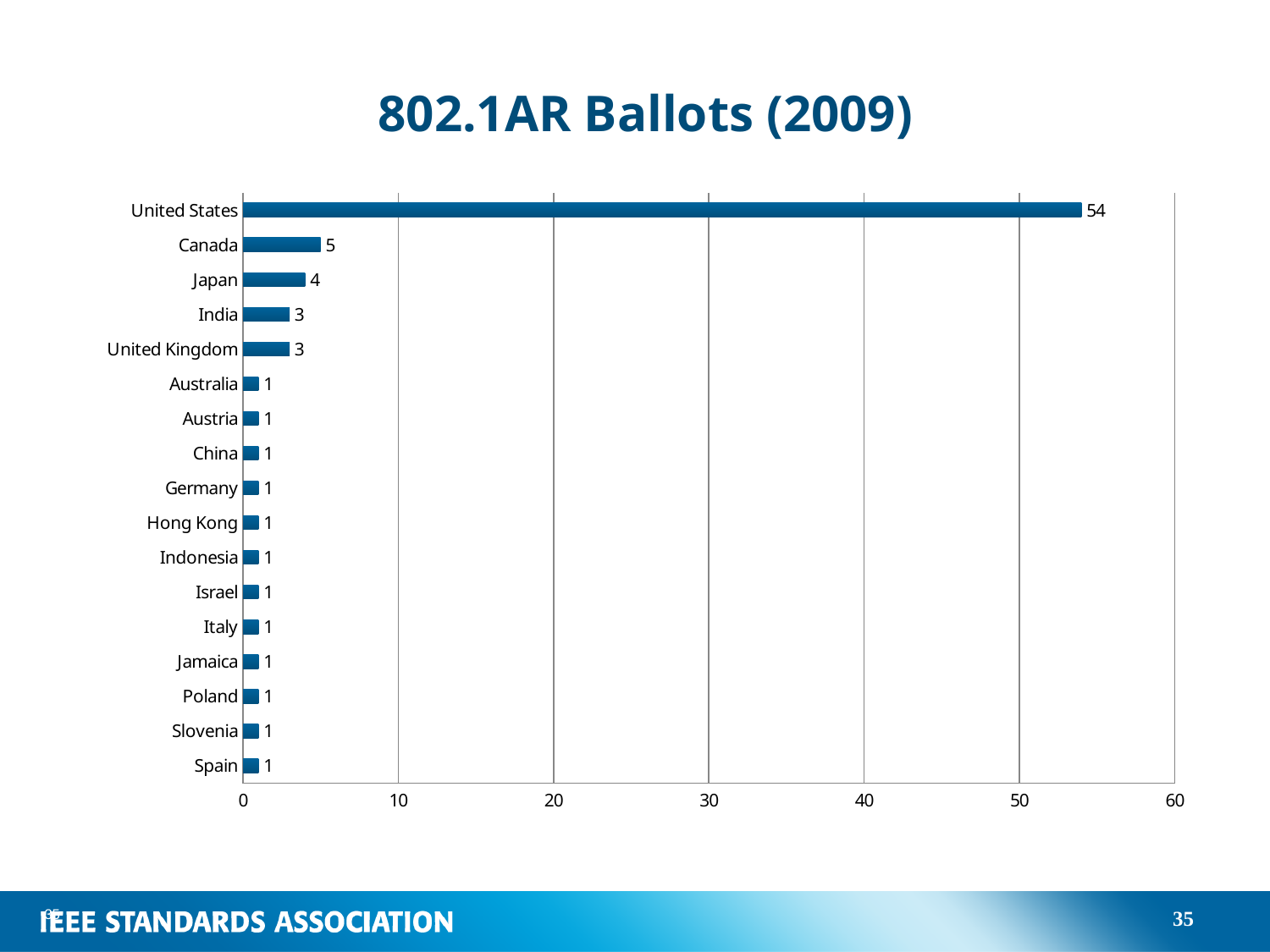
What is the value for United States? 54 Is the value for United States greater or less than 50? greater How many countries are shown in the chart? 17 Which is larger, the value for Japan or the value for India? Japan What is the title of the chart? 802.1AR Ballots (2009) What is the value for Japan? 4 What kind of chart is shown on the slide? bar chart What is the difference between the values for United States and Canada? 49 What is the value for United Kingdom? 3 What is the value for Canada? 5 What is the difference between the values for Canada and India? 2 Which country has the highest value? United States